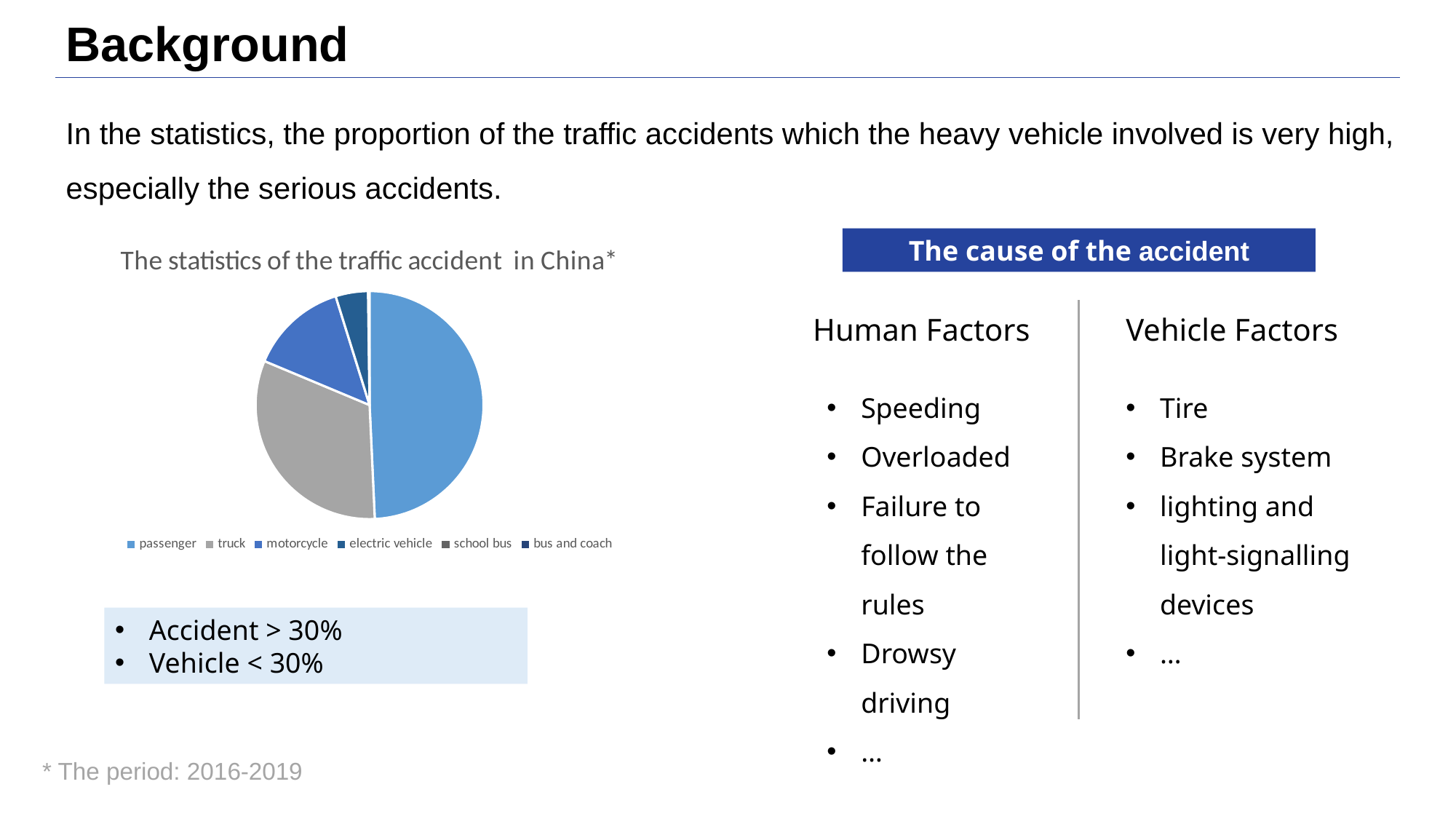
Which slice is larger in the pie chart, motorcycle or electric vehicle? motorcycle Which category is shown in grey in the pie chart? truck How many categories does the legend of the pie chart list? 6 Which slice is larger in the pie chart, truck or motorcycle? truck Which slice is larger in the pie chart, passenger or truck? passenger Which category is listed first in the pie chart's legend? passenger What is the title of the pie chart? The statistics of the traffic accident in China* Which category has the largest slice in the pie chart? passenger What kind of chart is shown on the slide? pie chart